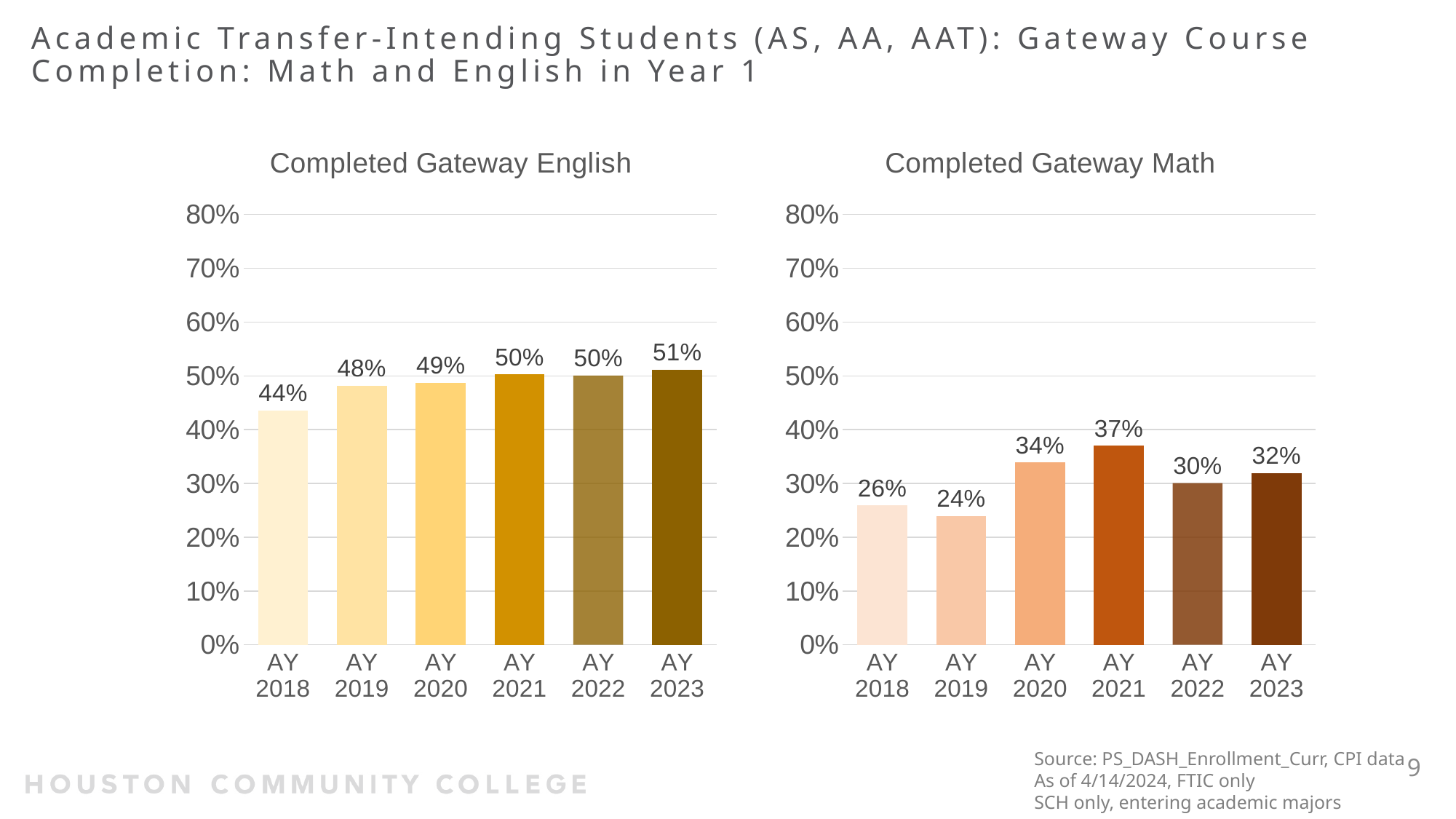
In the Completed Gateway English chart, is the value for AY 2019 greater or less than 40%? greater In the Completed Gateway English chart, which academic year has the highest value? AY 2023 In the Completed Gateway English chart, what is the difference between AY 2023 and AY 2018? 7% What kind of chart is the Completed Gateway English chart? Bar chart In the Completed Gateway Math chart, what is the value for AY 2021? 37% In the Completed Gateway Math chart, what is the difference between AY 2021 and AY 2022? 7% In the Completed Gateway English chart, do the values generally rise or fall from AY 2018 to AY 2023? Rise How many academic years are shown in the Completed Gateway Math chart? 6 In the Completed Gateway Math chart, which academic year has the lowest value? AY 2019 In the Completed Gateway English chart, what is the value for AY 2018? 44% In the Completed Gateway Math chart, which is larger, AY 2020 or AY 2022? AY 2020 In the Completed Gateway Math chart, what is the value for AY 2023? 32%